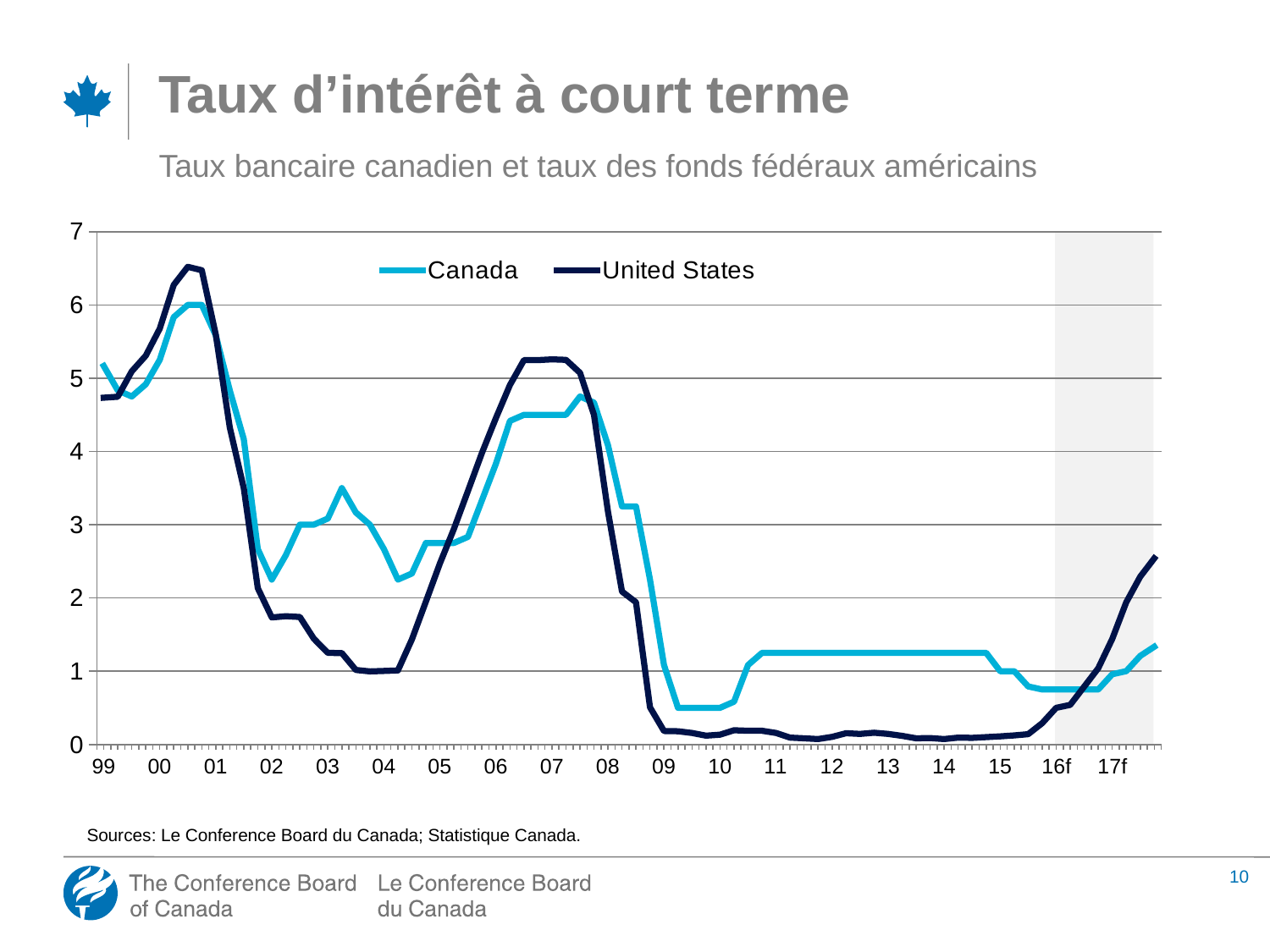
Is the peak value for United States around 2000 greater or less than 6? greater Do the values for United States rise or fall between 2007 and 2009? fall How many series does the legend list? 2 Is the value for United States in 2004 greater or less than 2? less Is the value for United States in 2012 greater or less than 1? less What are the two series named in the legend? Canada and United States What is the title of the slide containing the chart? Taux d’intérêt à court terme What kind of chart is shown on the slide? line chart In 2012, which series has the higher value, Canada or United States? Canada In 2007, which series has the higher value, Canada or United States? United States How many year labels are shown along the x axis? 19